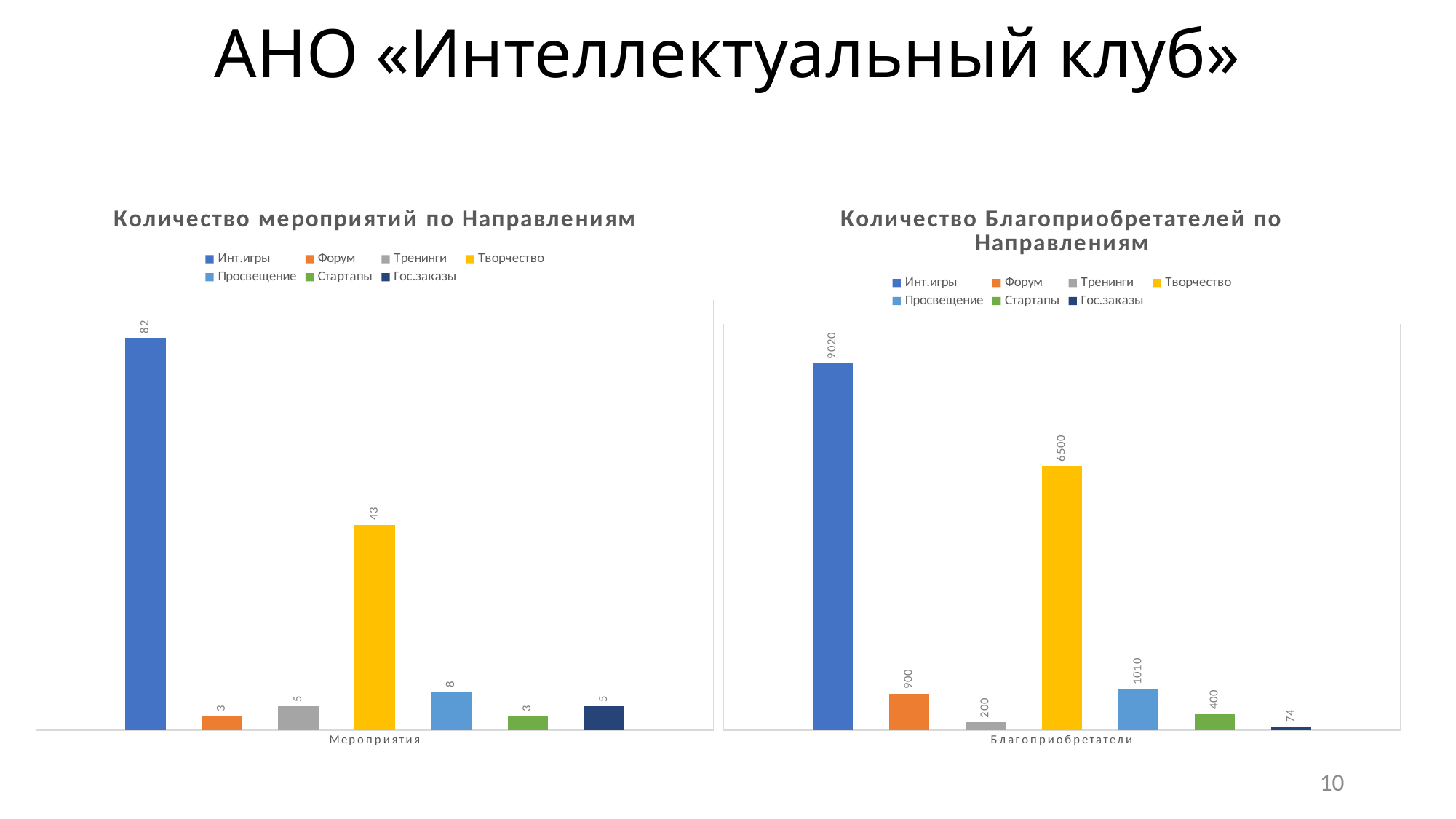
In the chart "Количество мероприятий по Направлениям", what colour is the bar for Творчество? yellow In the chart "Количество мероприятий по Направлениям", what is the value for Творчество? 43 In the chart "Количество мероприятий по Направлениям", how many series does the legend list? 7 In the chart "Количество мероприятий по Направлениям", what is the value for Инт.игры? 82 In the chart "Количество Благоприобретателей по Направлениям", what is the value for Гос.заказы? 74 In the chart "Количество Благоприобретателей по Направлениям", what is the difference between Творчество and Просвещение? 5490 In the chart "Количество мероприятий по Направлениям", which series has the highest value? Инт.игры In the chart "Количество Благоприобретателей по Направлениям", which is larger, Форум or Просвещение? Просвещение In the chart "Количество Благоприобретателей по Направлениям", what is the value for Инт.игры? 9020 What kind of chart is "Количество Благоприобретателей по Направлениям"? bar chart In the chart "Количество Благоприобретателей по Направлениям", which series has the lowest value? Гос.заказы In the chart "Количество мероприятий по Направлениям", what is the difference between Инт.игры and Творчество? 39